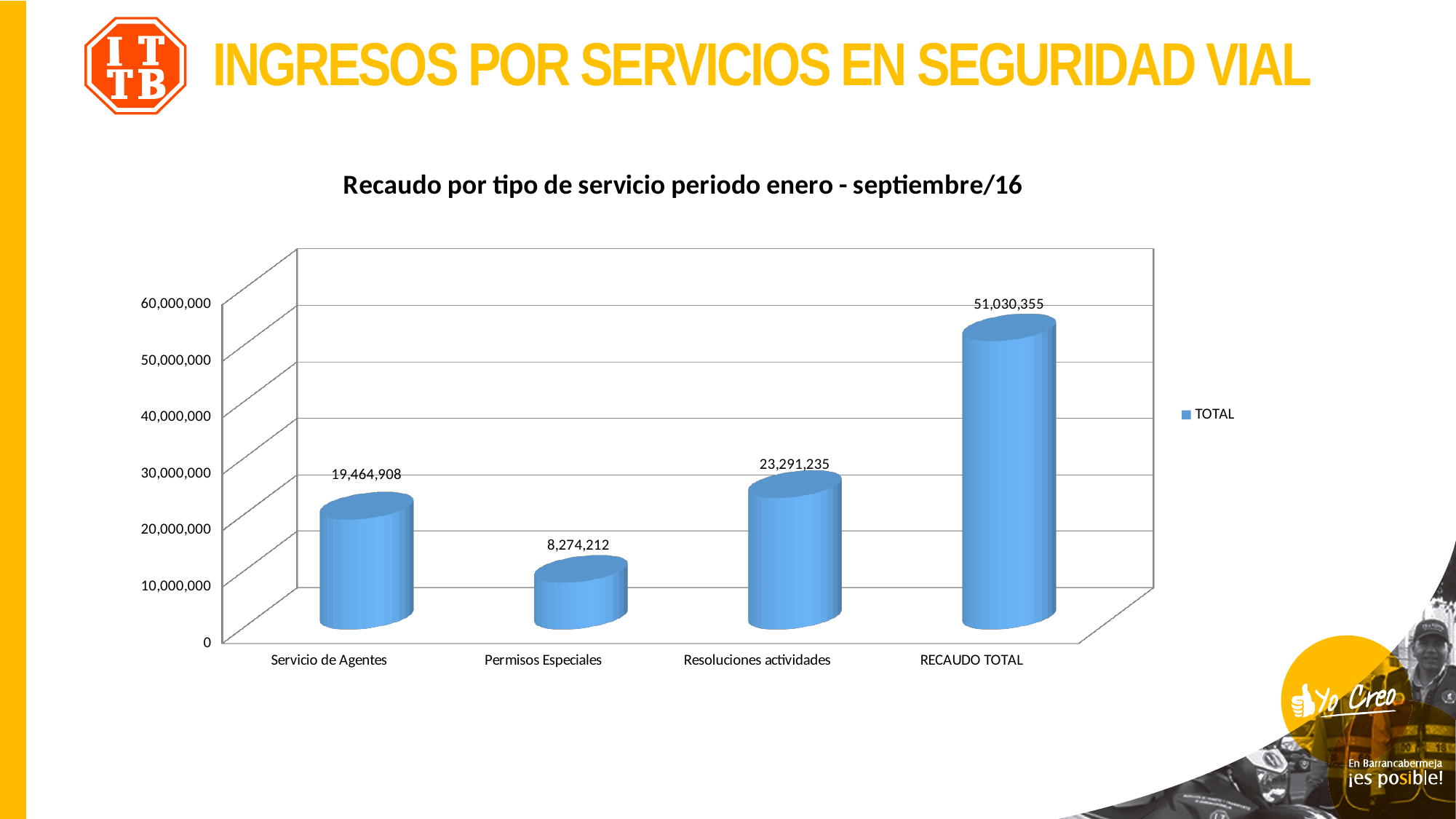
What is the value for Servicio de Agentes? 19,464,908 How many categories are shown on the x axis? 4 What is the difference between Resoluciones actividades and Servicio de Agentes? 3,826,327 What is the value for Resoluciones actividades? 23,291,235 What kind of chart is shown? Bar chart What is the value for RECAUDO TOTAL? 51,030,355 Which is larger, Servicio de Agentes or Resoluciones actividades? Resoluciones actividades What is the value for Permisos Especiales? 8,274,212 Which category has the lowest value? Permisos Especiales How many series does the legend list? 1 Is the value for Permisos Especiales greater or less than 10,000,000? less Which category has the highest value? RECAUDO TOTAL